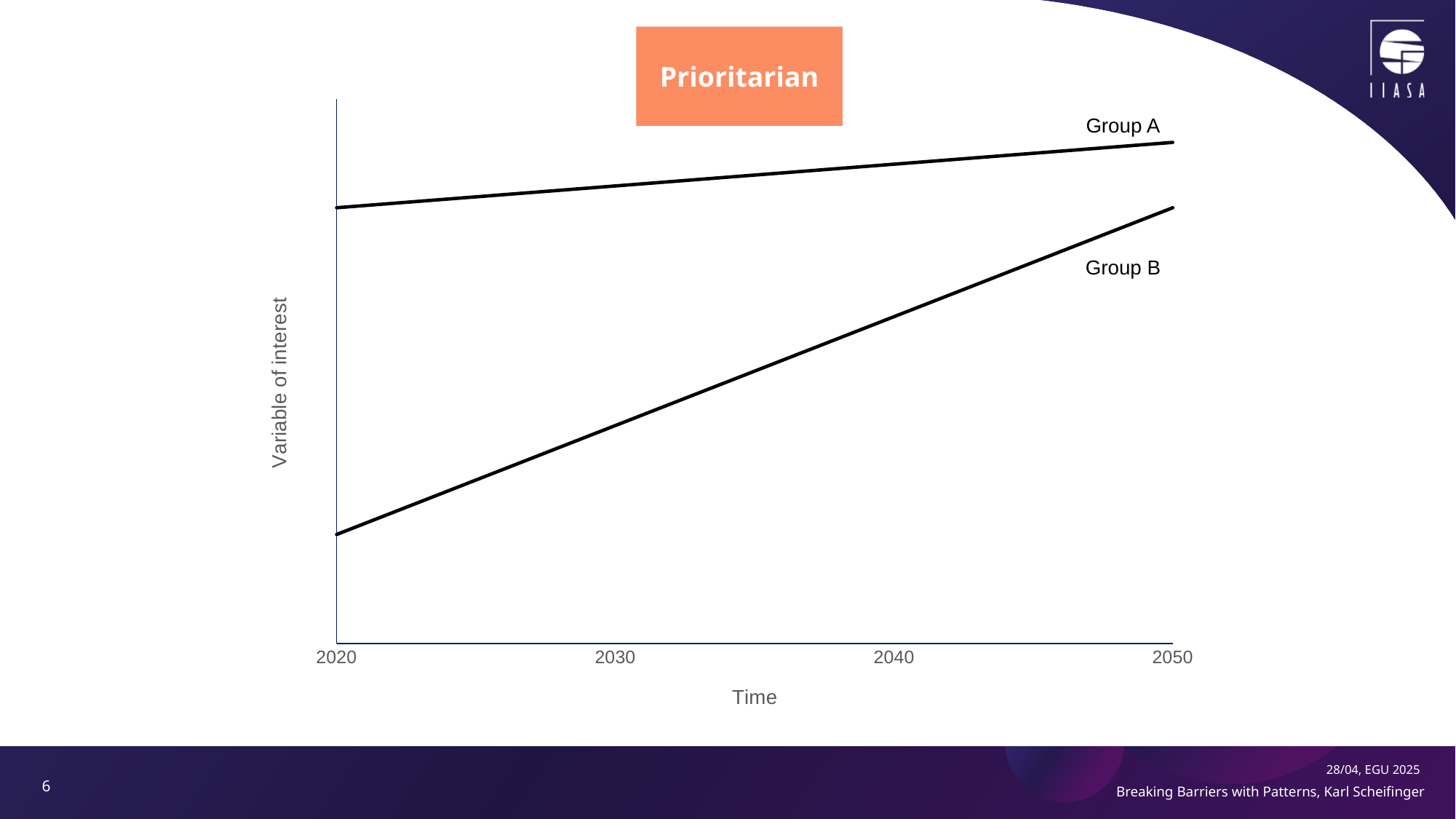
Which group has the lowest value at the start of the chart in 2020? Group B Which group has the higher value in 2050, Group A or Group B? Group A How many lines (groups) are plotted on the chart? 2 What kind of chart is shown on the slide? line chart What is the label of the y axis? Variable of interest Does the line for Group B rise or fall from 2020 to 2050? rise Which group has the higher value in 2020, Group A or Group B? Group A Which groups are labelled on the chart? Group A and Group B How many year labels are shown on the x axis? 4 Which group's line rises more steeply over time? Group B Does the line for Group A rise or fall from 2020 to 2050? rise What is the title shown above the chart? Prioritarian